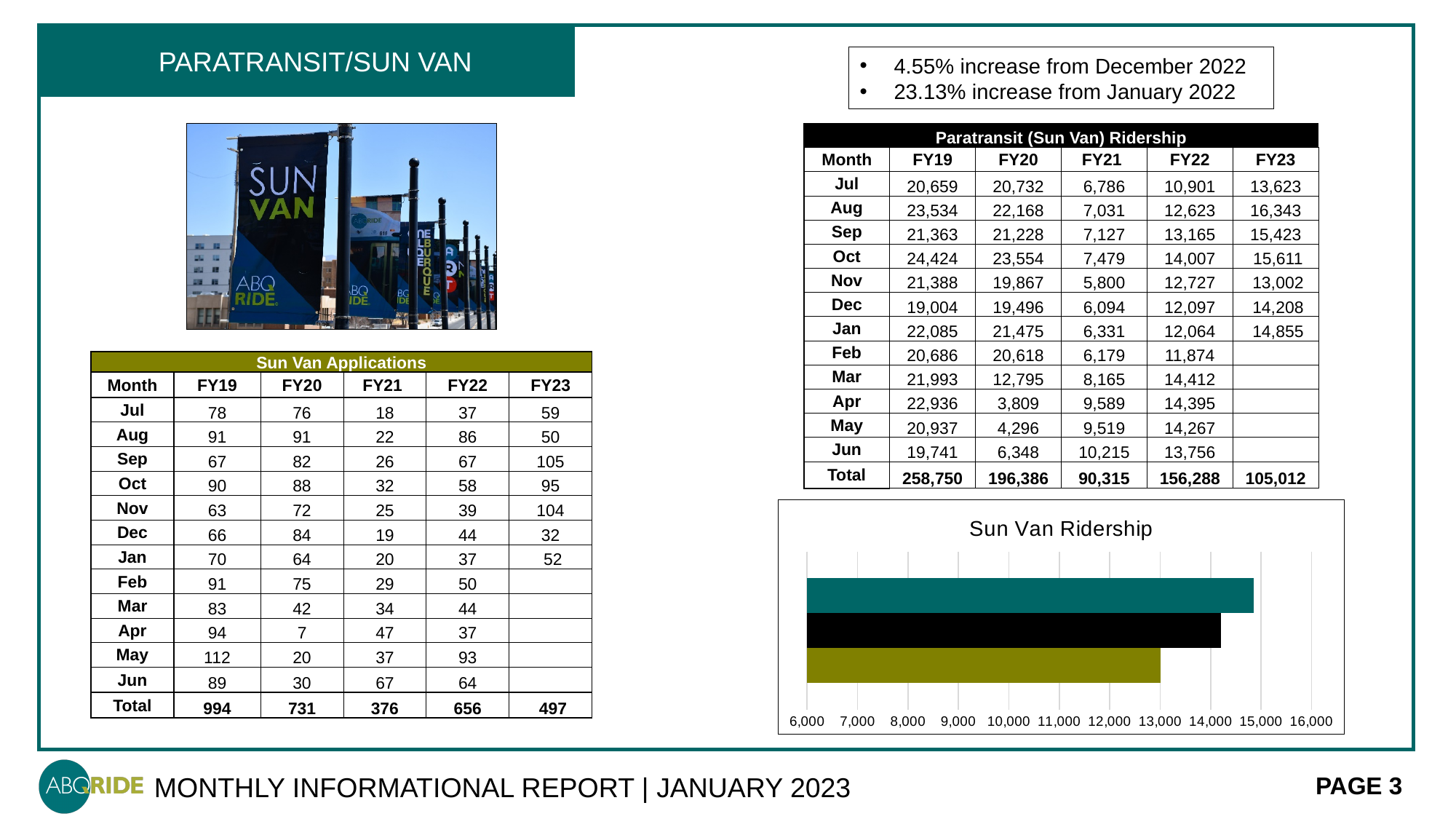
In the "Sun Van Ridership" chart, is the value of the bottom (olive) bar greater or less than 14,000? less In the "Sun Van Ridership" chart, is the value of the bottom (olive) bar greater or less than 12,000? greater In the "Sun Van Ridership" chart, which bar is the shortest: the top (teal), middle (black), or bottom (olive) bar? bottom (olive) In the "Sun Van Ridership" chart, is the value of the top (teal) bar greater or less than 14,000? greater What is the highest value shown on the x axis of the "Sun Van Ridership" chart? 16,000 What kind of chart is the "Sun Van Ridership" chart? bar chart What is the title of the bar chart on the slide? Sun Van Ridership In the "Sun Van Ridership" chart, which bar is the longest: the top (teal), middle (black), or bottom (olive) bar? top (teal) In the "Sun Van Ridership" chart, which is larger: the top (teal) bar or the bottom (olive) bar? top (teal) bar How many bars are plotted in the "Sun Van Ridership" chart? 3